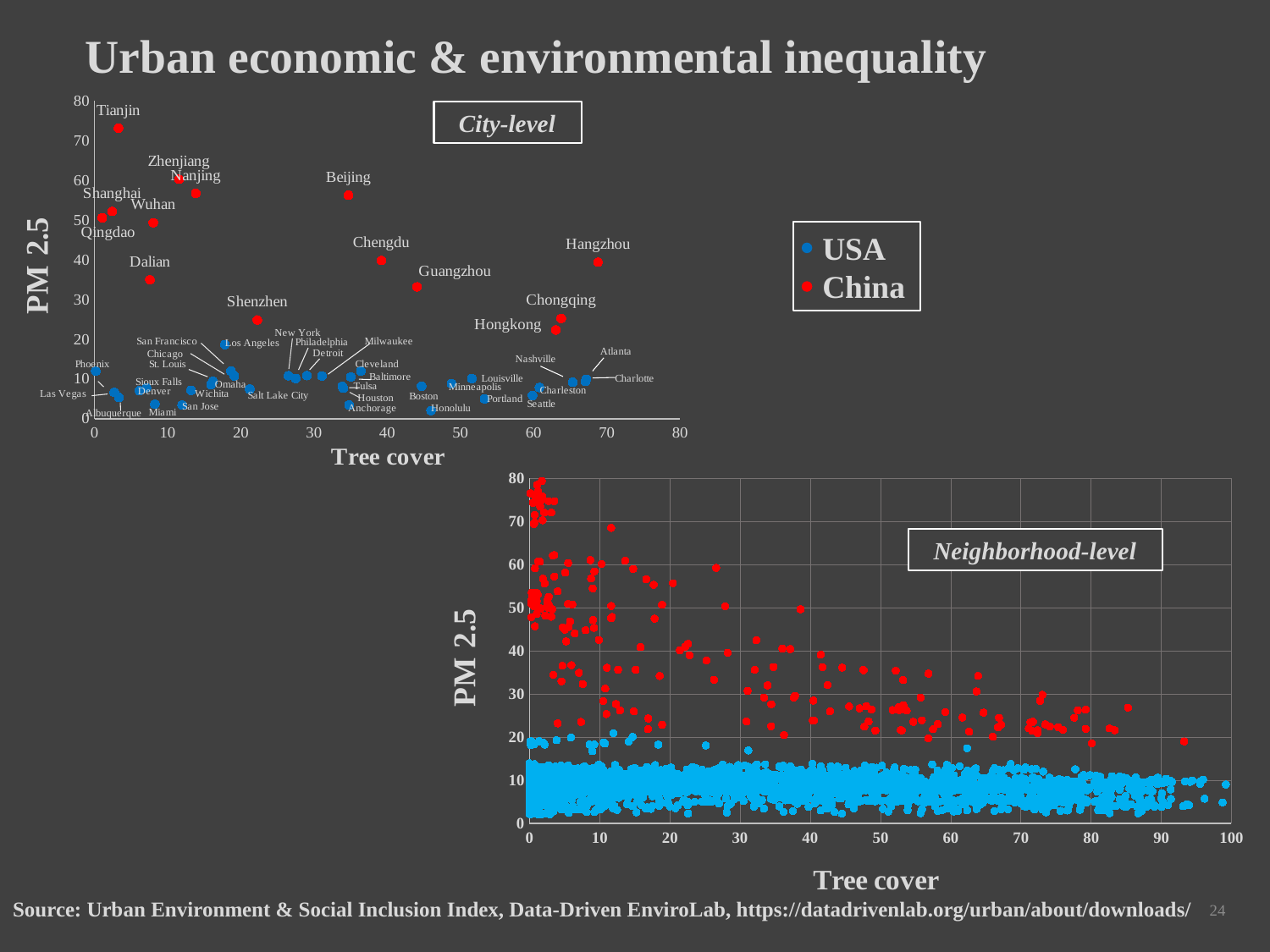
In the City-level chart, which city has the highest PM 2.5 value? Tianjin What kind of chart is the City-level chart? scatter chart In the City-level chart, which has the higher PM 2.5 value, Tianjin or Beijing? Tianjin In the City-level chart, is the tree cover value for Hangzhou greater or less than 60? greater In the City-level chart, which has the higher tree cover value, Beijing or Hangzhou? Hangzhou In the City-level chart, is the PM 2.5 value for Hongkong greater or less than 30? less In the City-level chart, is the PM 2.5 value for Beijing greater or less than 50? greater Which colour represents China in the charts? red In the Neighborhood-level chart, do the PM 2.5 values for China rise or fall as tree cover increases? fall How many series does the legend list? 2 In the City-level chart, which Chinese city has the highest tree cover value? Hangzhou